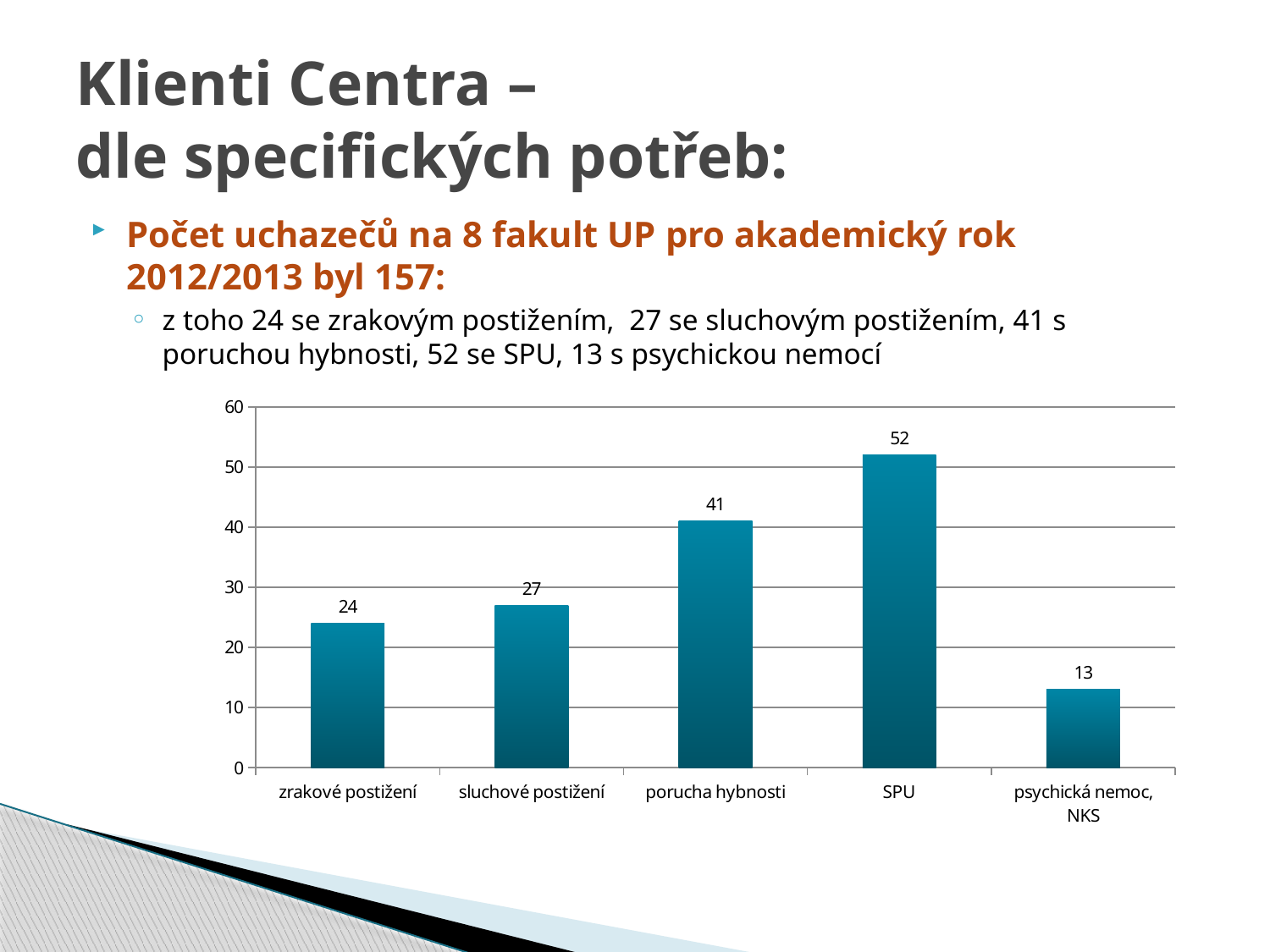
What kind of chart is shown on the slide? bar chart How many categories are shown on the x axis? 5 What is the value for zrakové postižení? 24 Which is larger, the value for porucha hybnosti or the value for sluchové postižení? porucha hybnosti What is the difference between the values for sluchové postižení and zrakové postižení? 3 What is the difference between the values for SPU and porucha hybnosti? 11 What is the value for psychická nemoc, NKS? 13 What is the value for SPU? 52 Which category has the highest value? SPU Is the value for porucha hybnosti greater or less than 30? greater What is the highest value shown on the y axis? 60 Which category has the lowest value? psychická nemoc, NKS